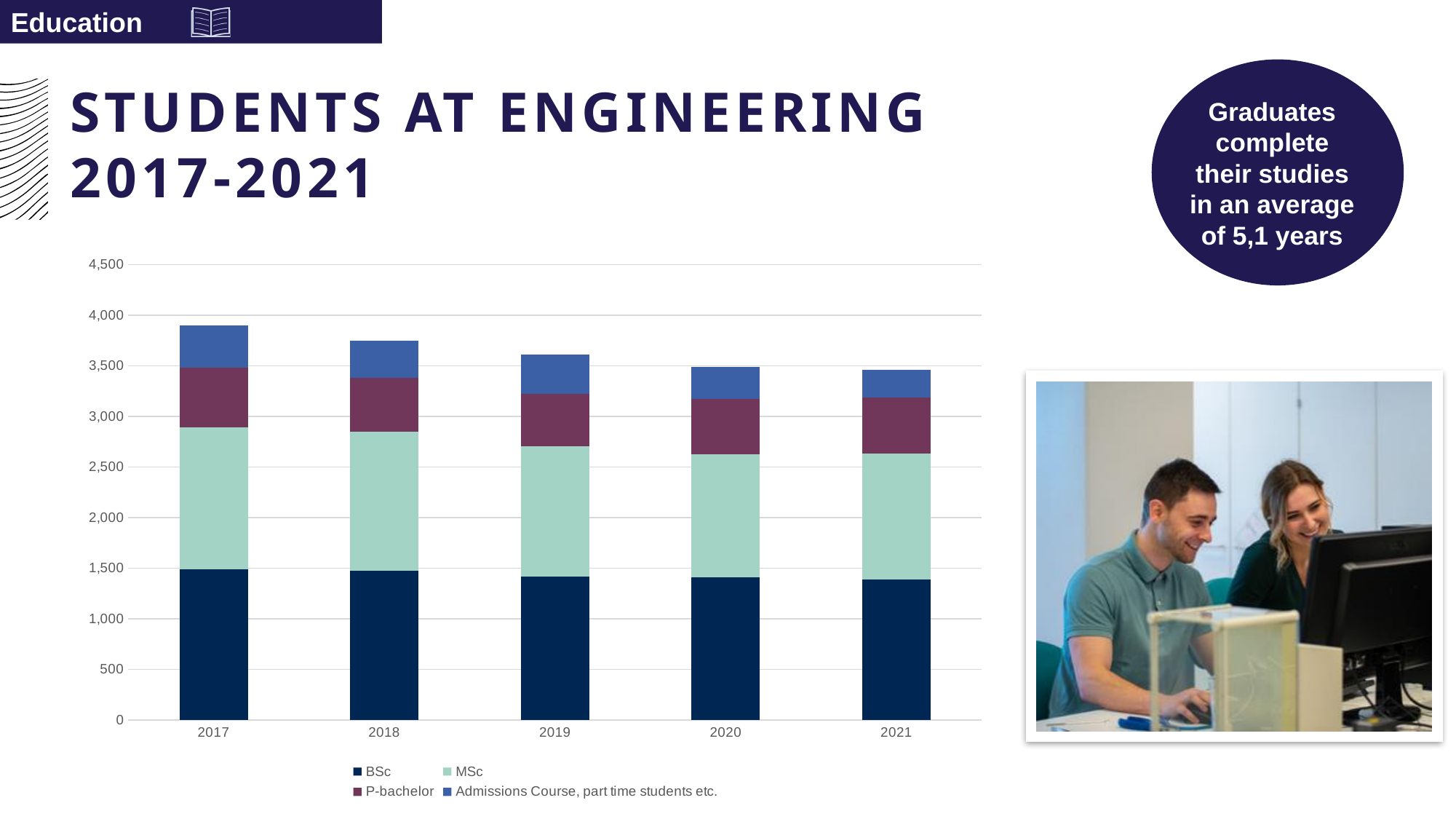
Is the total number of students in 2017 greater or less than 3,500? greater How many series does the chart legend list? 4 Which series forms the bottom segment of each bar? BSc What is the title of the slide containing the chart? STUDENTS AT ENGINEERING 2017-2021 Is the BSc value for 2017 greater or less than 2,000? less Do the total bar heights rise or fall from 2017 to 2021? Fall Which series is the largest segment in every bar of the chart? BSc How many years are shown on the x axis of the chart? 5 Which is larger, the total number of students in 2017 or in 2018? 2017 Which year has the highest total number of students in the chart? 2017 What kind of chart is shown on the slide? Stacked bar chart Is the total number of students in 2020 greater or less than 4,000? less